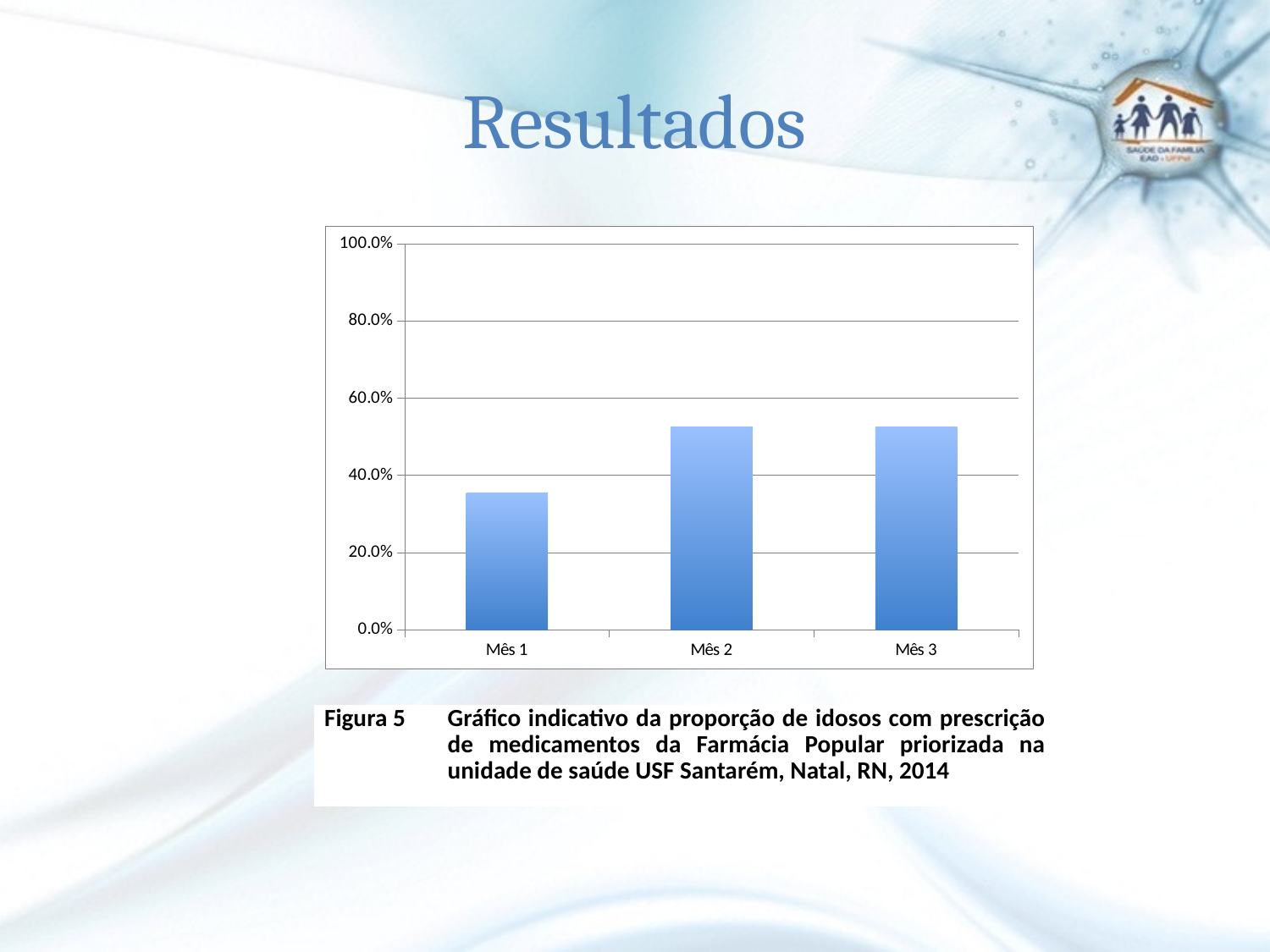
Is the value for Mês 2 greater or less than 40.0%? greater Is the value for Mês 2 greater or less than 60.0%? less What kind of chart is shown on the slide? bar chart Is the value for Mês 1 greater or less than 40.0%? less Which month has the lowest value? Mês 1 Which is larger, the value for Mês 1 or the value for Mês 2? Mês 2 How many categories (months) are plotted on the x axis? 3 What is the highest value shown on the y axis? 100.0% Does the value rise or fall from Mês 1 to Mês 2? rise